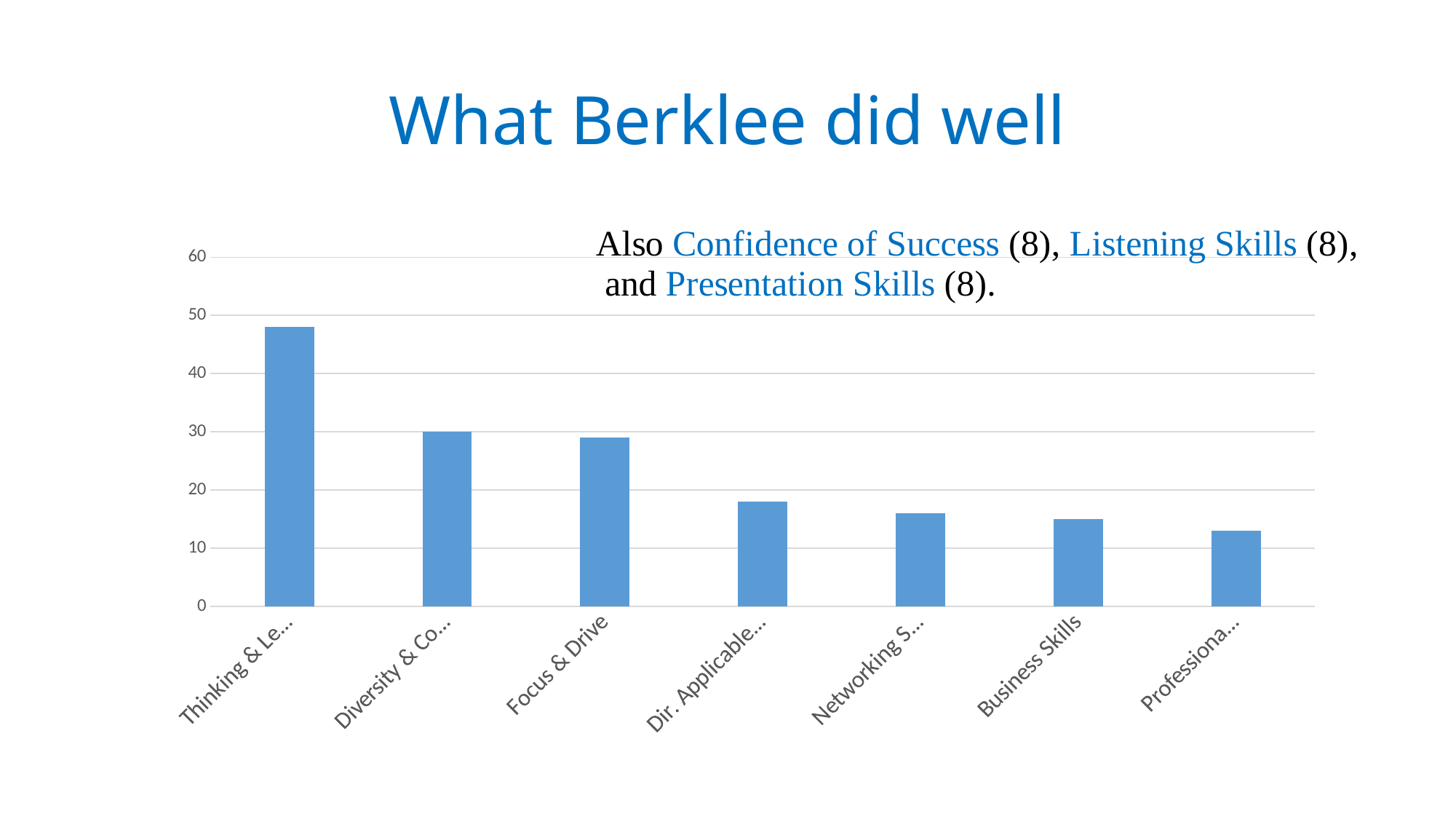
Which category has the lowest bar in the chart? Professiona... (the last bar) What is the value for Diversity & Co..., whose bar lands on an axis gridline? 30 Which category has the highest bar in the chart? Thinking & Le... (the first bar) What kind of chart is shown on the slide? bar chart Is the value for Focus & Drive greater or less than 20? greater Do the bar values rise or fall from left to right across the chart? fall Is the value for the first bar (Thinking & Le...) greater or less than 40? greater What is the title of the slide containing the chart? What Berklee did well How many bars (categories) does the chart show? 7 Which is larger, the value for Focus & Drive or the value for Business Skills? Focus & Drive Is the value for Business Skills greater or less than 20? less